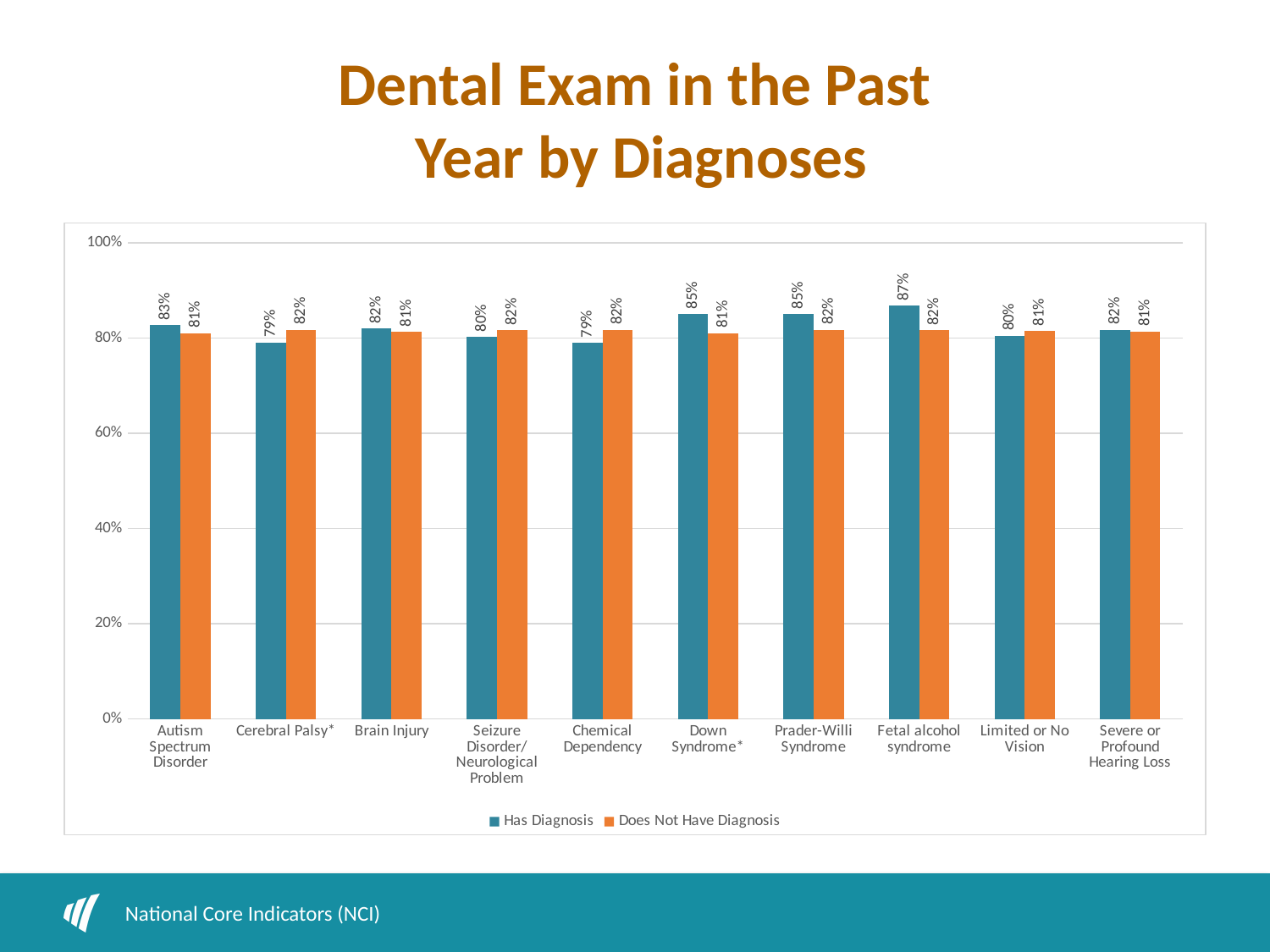
What is the value for Has Diagnosis for Fetal alcohol syndrome? 87% What is the difference between the Has Diagnosis and Does Not Have Diagnosis values for Down Syndrome*? 4 percentage points What kind of chart is shown on the slide? Bar chart What is the value for Does Not Have Diagnosis for Cerebral Palsy*? 82% What is the difference between the Has Diagnosis and Does Not Have Diagnosis values for Fetal alcohol syndrome? 5 percentage points How many series does the legend list? 2 What is the value for Does Not Have Diagnosis for Limited or No Vision? 81% For Cerebral Palsy*, which is larger: the Has Diagnosis value or the Does Not Have Diagnosis value? Does Not Have Diagnosis What is the title of the chart? Dental Exam in the Past Year by Diagnoses How many diagnosis categories are shown on the x axis? 10 Which diagnosis has the highest Has Diagnosis value? Fetal alcohol syndrome What is the value for Has Diagnosis for Down Syndrome*? 85%